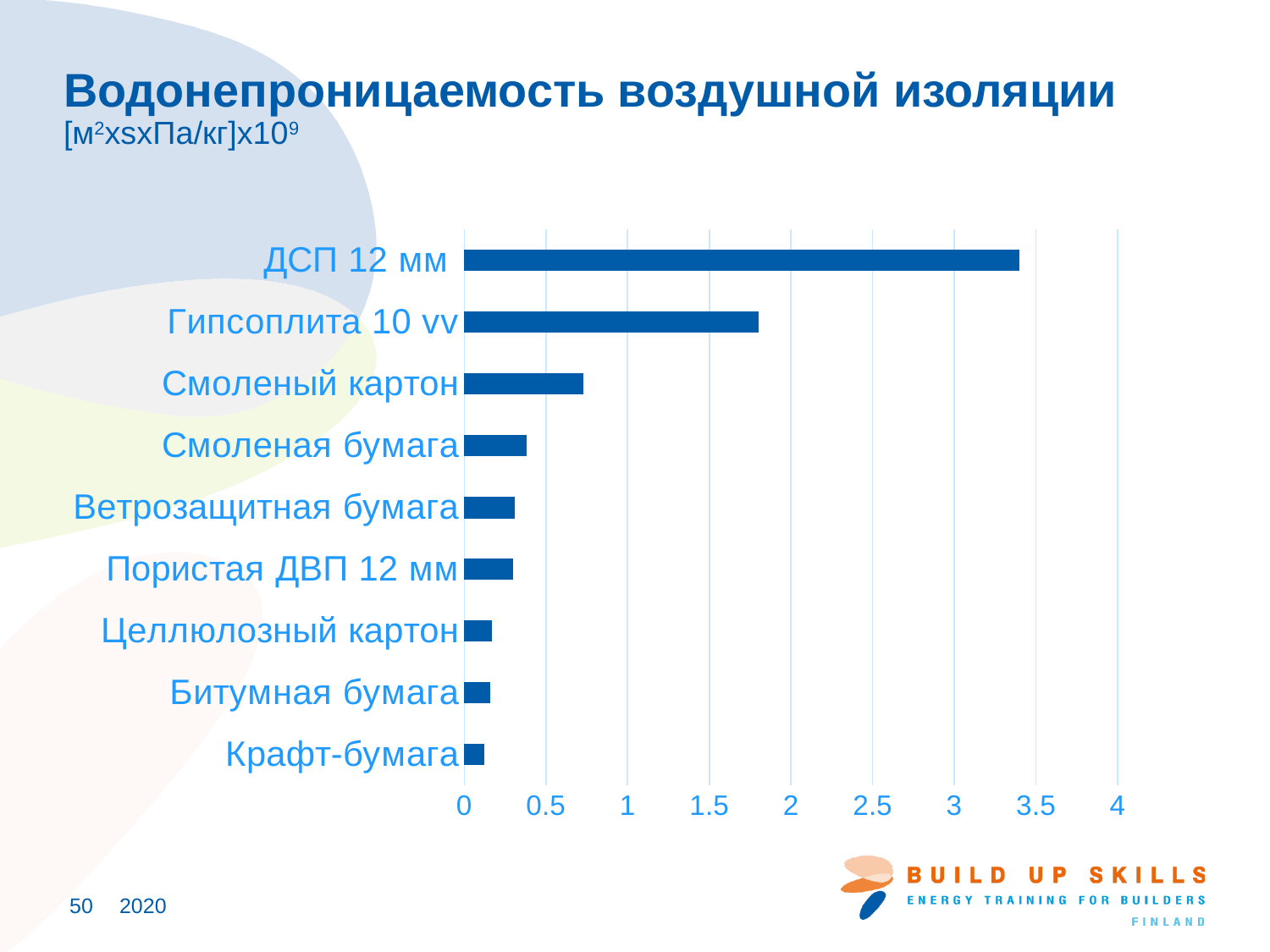
Which has the larger value, Смоленый картон or Смоленая бумага? Смоленый картон What kind of chart is shown on the slide? bar chart Is the value for ДСП 12 мм greater or less than 3? greater What is the title of the slide above the chart? Водонепроницаемость воздушной изоляции What is the highest tick value shown on the horizontal axis? 4 Which material has the highest value in the chart? ДСП 12 мм How many materials (categories) are plotted in the chart? 9 Which has the larger value, ДСП 12 мм or Гипсоплита 10 vv? ДСП 12 мм Is the value for Гипсоплита 10 vv greater or less than 2? less Is the value for Смоленая бумага greater or less than 0.5? less